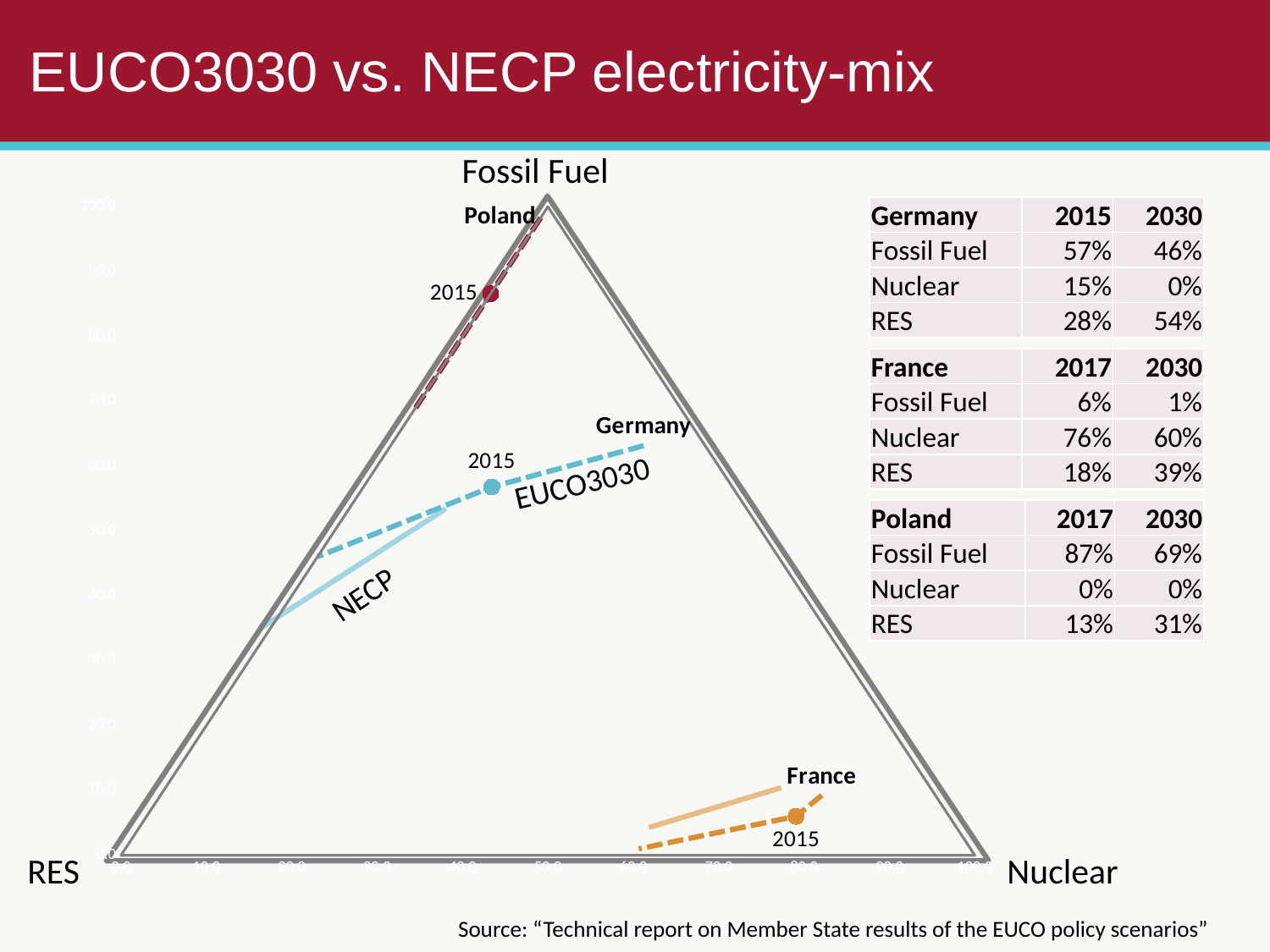
By how many percentage points does Germany's RES share increase from 2015 to 2030? 26 percentage points Which country has the lowest Fossil Fuel share in 2030? France What is Germany's Fossil Fuel share in 2015? 57% Which is larger in 2030: Germany's RES share or France's RES share? Germany's RES share What are the three corners of the triangle chart labelled? Fossil Fuel, RES, Nuclear What kind of chart is shown on the slide? Ternary (triangle) chart What is Germany's Nuclear share in 2030? 0% How many countries are plotted on the chart? 3 What is France's Nuclear share in 2030? 60% Which scenario is drawn with dashed lines on the chart? EUCO3030 What is Poland's RES share in 2017? 13% Which country has the highest Fossil Fuel share in 2030? Poland